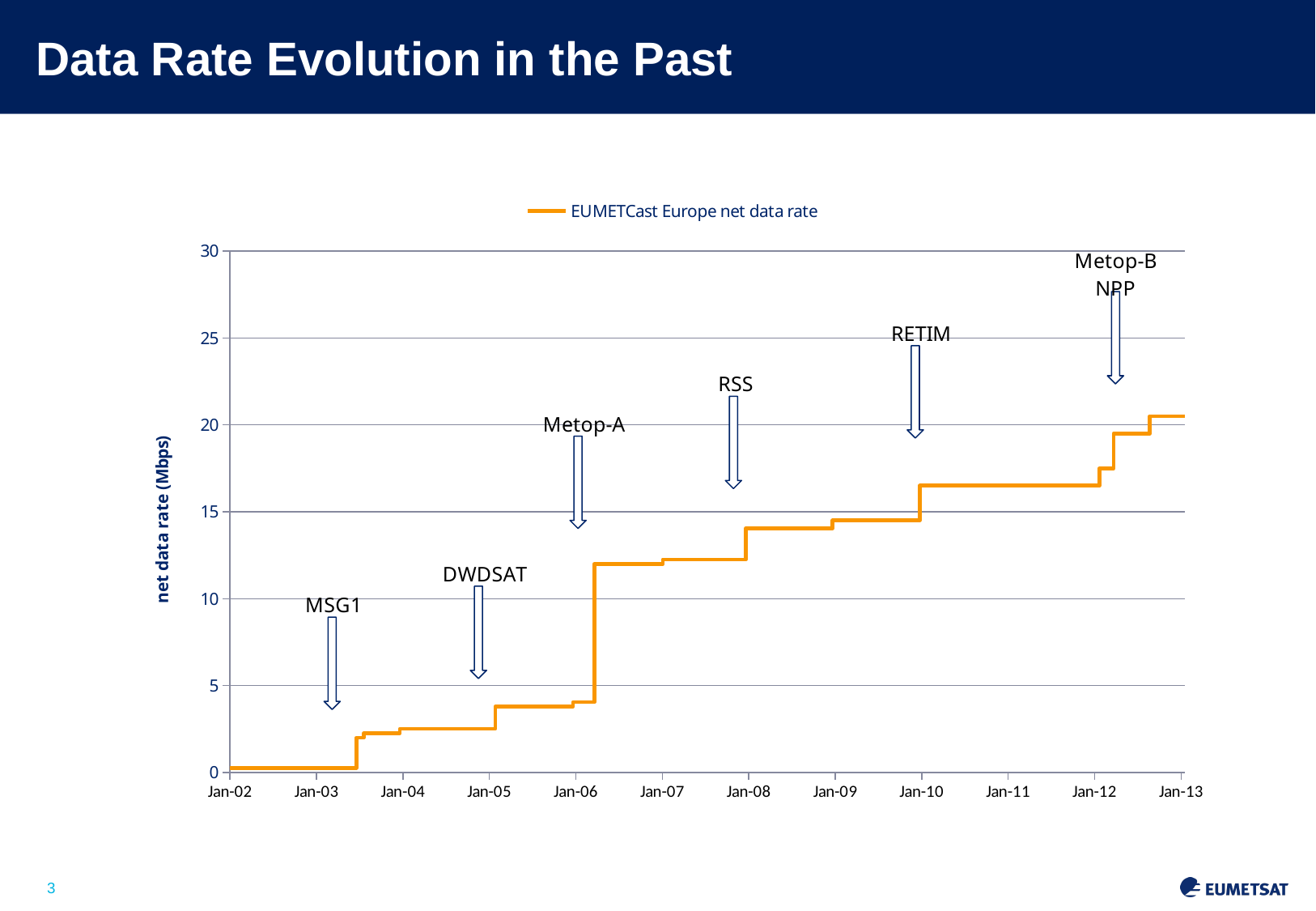
How many series does the legend list? 1 What kind of chart is shown on the slide? line chart Which is larger, the value for Jan-05 or the value for Jan-12? Jan-12 Does the net data rate rise or fall from Jan-02 to Jan-13? rise What is the label of the vertical axis? net data rate (Mbps) Is the value for Jan-11 greater or less than 15? greater Is the value for Jan-13 greater or less than 20? greater Is the value for Jan-09 greater or less than 15? less How many tick labels are shown on the x axis? 12 What is the name of the series shown in the legend? EUMETCast Europe net data rate